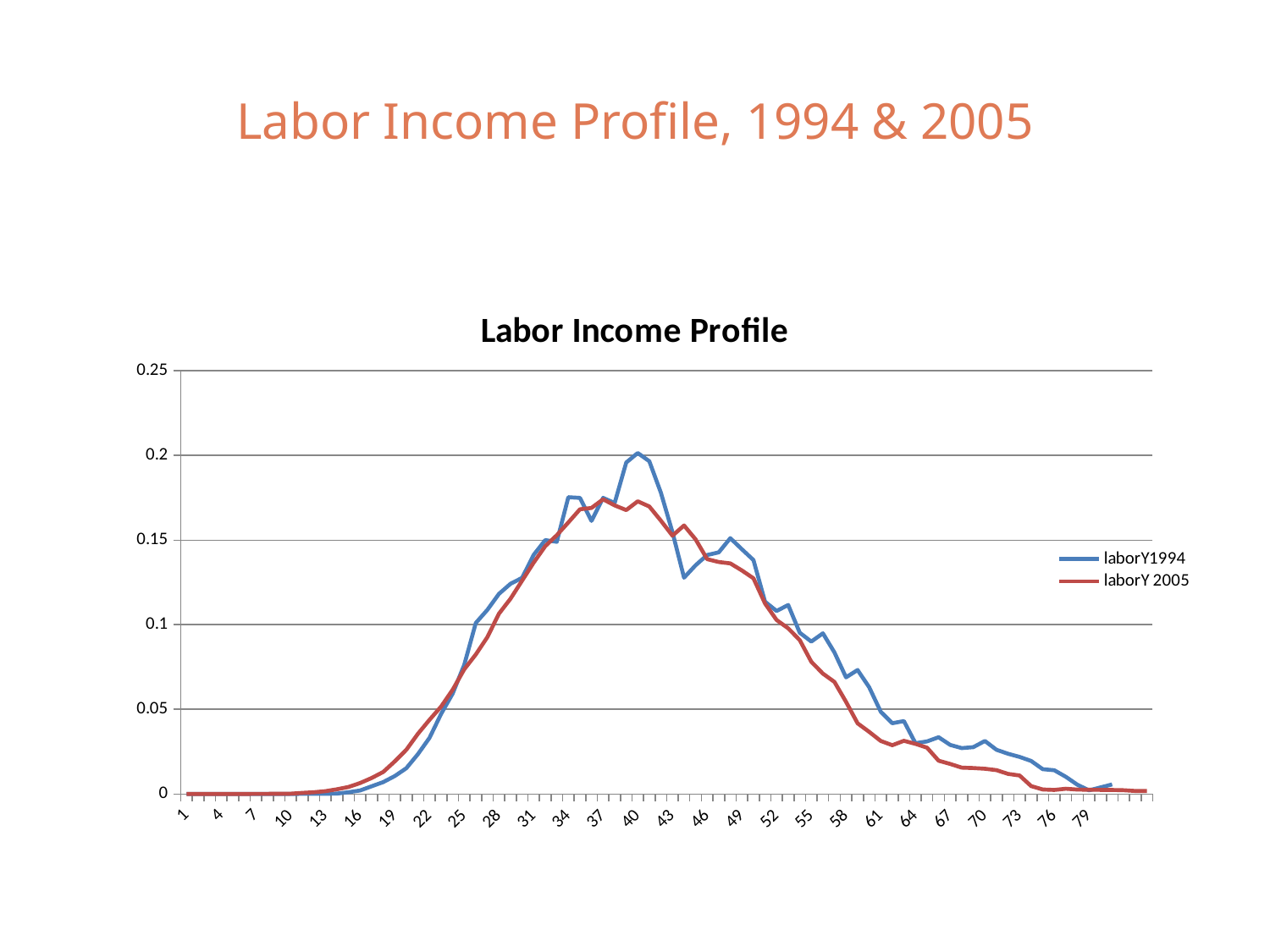
What is the title printed above the chart? Labor Income Profile What are the two series names shown in the legend? laborY1994 and laborY 2005 At x = 40, which series has the higher value, laborY1994 or laborY 2005? laborY1994 Is the value of laborY 2005 at x = 58 greater or less than 0.1? less Do the values of laborY 2005 rise or fall between x = 25 and x = 37? rise Is the value of laborY1994 at x = 40 greater or less than 0.15? greater Do the values of laborY1994 generally rise or fall between x = 49 and x = 79? fall Is the value of laborY1994 at x = 22 greater or less than 0.05? less Which series reaches the higher peak value? laborY1994 How many series does the legend list? 2 What kind of chart is shown on the slide? line chart